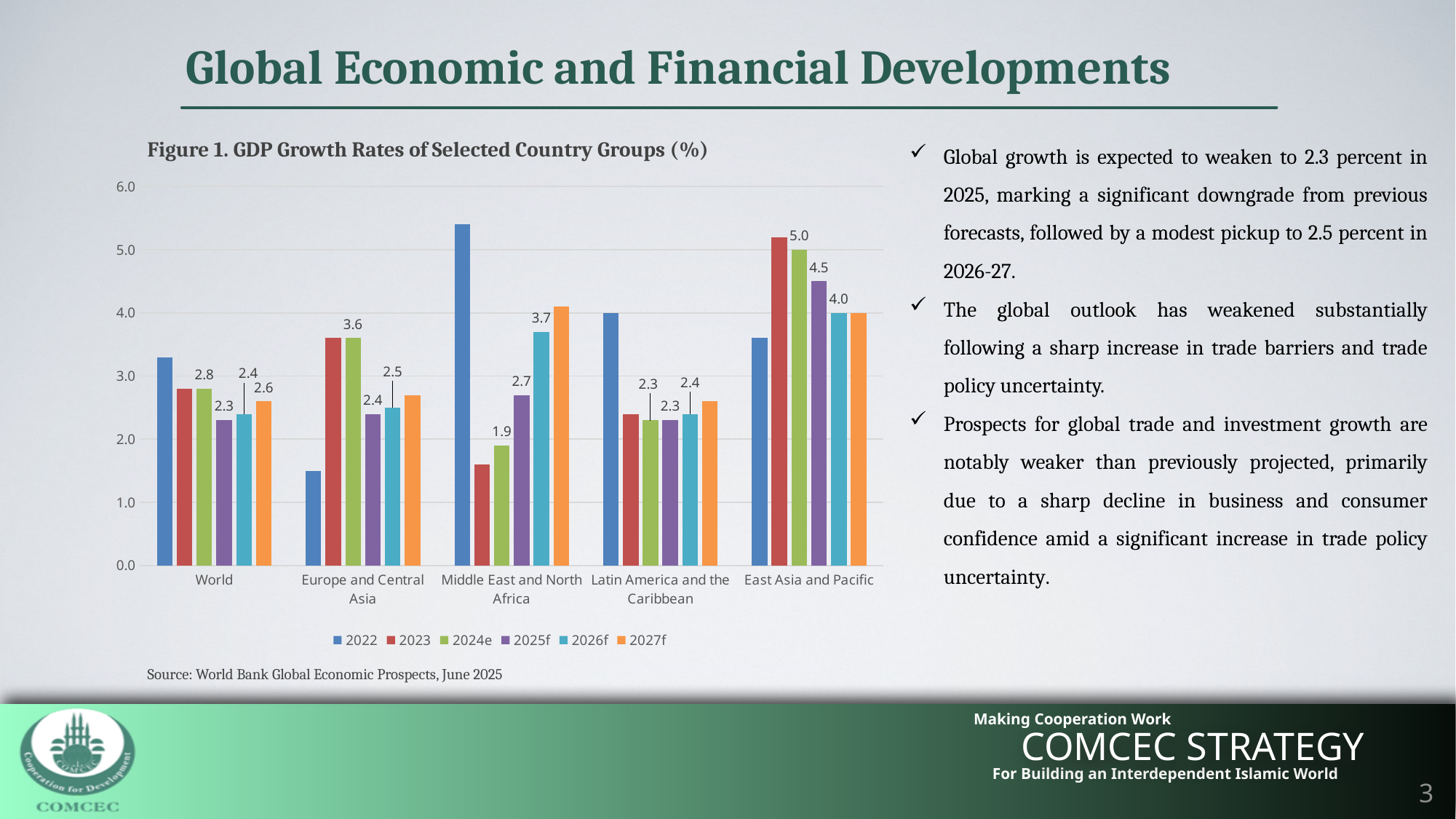
In Figure 1, how much higher is the 2025f growth rate for East Asia and Pacific than for World? 2.2 What is the 2025f GDP growth rate for World in Figure 1? 2.3 What is the 2026f GDP growth rate for Europe and Central Asia in Figure 1? 2.5 What is the 2026f GDP growth rate for Middle East and North Africa in Figure 1? 3.7 In Figure 1, is the 2022 GDP growth rate for Middle East and North Africa greater or less than 5.0? greater What is the 2024e GDP growth rate for East Asia and Pacific in Figure 1? 5.0 Which country group has the highest 2025f GDP growth rate in Figure 1? East Asia and Pacific How many series does the legend of Figure 1 list? 6 How many country groups are shown on the x axis of Figure 1? 5 Which country group has the lowest 2024e GDP growth rate in Figure 1? Middle East and North Africa In Figure 1, which has the larger 2026f growth rate: Middle East and North Africa or Latin America and the Caribbean? Middle East and North Africa What kind of chart is Figure 1? Bar chart